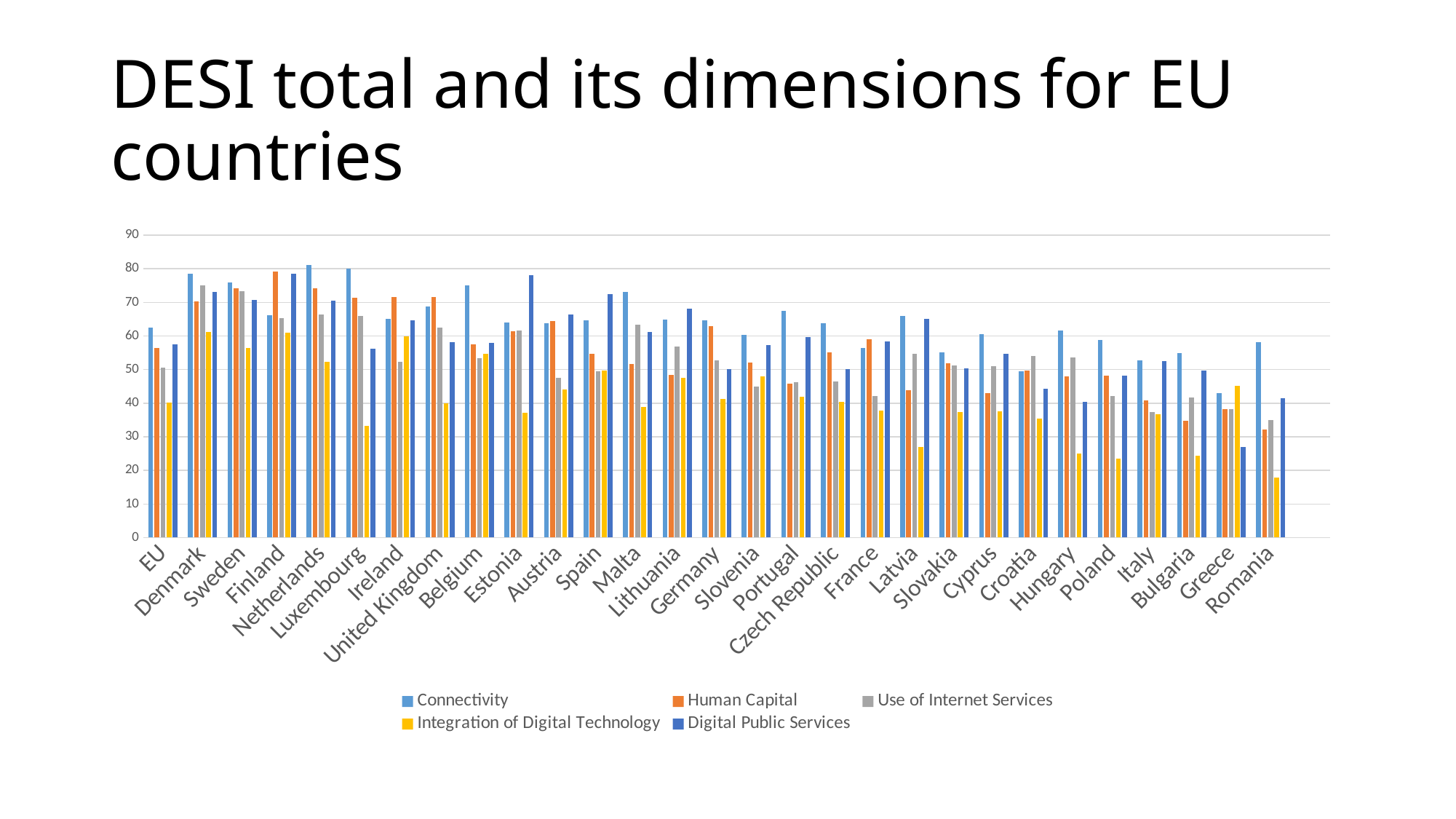
Which has the higher Connectivity value, Denmark or Romania? Denmark How many series does the legend list? 5 Which series is shown in yellow in the legend? Integration of Digital Technology Is the Integration of Digital Technology value for Romania greater or less than 20? less Which country has the lowest Integration of Digital Technology value? Romania Is the Integration of Digital Technology value for Latvia greater or less than 30? less What kind of chart is shown on the slide? bar chart How many countries/categories are shown on the x axis? 29 Is the Human Capital value for Finland greater or less than 70? greater Which country has the highest Human Capital value? Finland